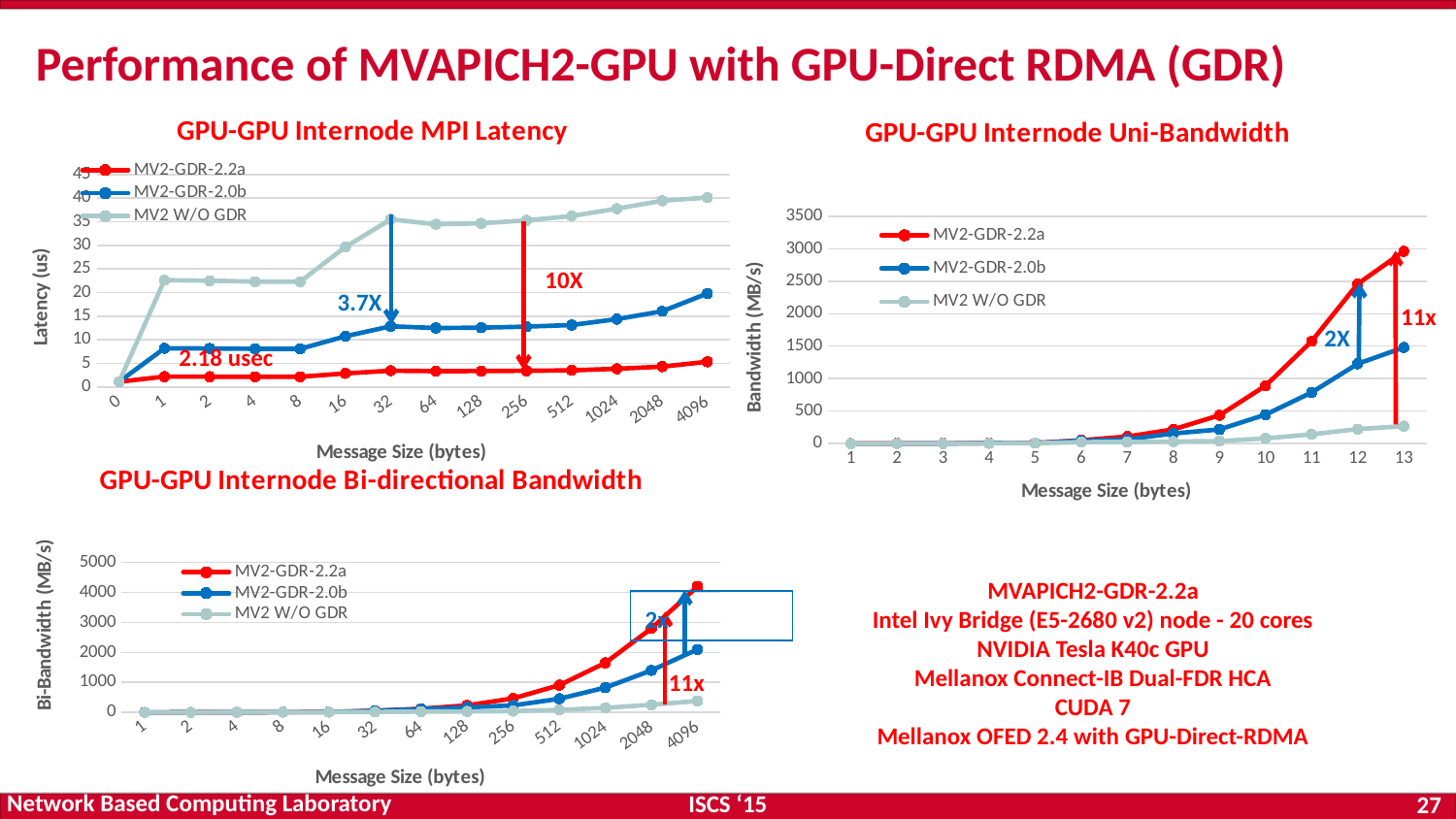
In the GPU-GPU Internode Uni-Bandwidth chart, which series has the lowest bandwidth at message size 13? MV2 W/O GDR In the GPU-GPU Internode Bi-directional Bandwidth chart, is the bi-bandwidth of MV2-GDR-2.2a at message size 4096 greater or less than 4000? greater How many series does the legend of the GPU-GPU Internode MPI Latency chart list? 3 In the GPU-GPU Internode MPI Latency chart, is the latency of MV2 W/O GDR at message size 4096 greater or less than 35? greater In the GPU-GPU Internode MPI Latency chart, which series has the highest latency at message size 4096? MV2 W/O GDR In the GPU-GPU Internode MPI Latency chart, which series has the lowest latency at message size 4096? MV2-GDR-2.2a In the GPU-GPU Internode Bi-directional Bandwidth chart, does the bi-bandwidth of MV2-GDR-2.2a rise or fall as message size increases? rise In the GPU-GPU Internode MPI Latency chart, is the latency of MV2-GDR-2.2a at message size 4096 greater or less than 10? less In the GPU-GPU Internode MPI Latency chart, what latency value is annotated for MV2-GDR-2.2a at small message sizes? 2.18 usec What kind of chart is the GPU-GPU Internode MPI Latency chart? line chart How many message-size points are plotted along the x axis of the GPU-GPU Internode Uni-Bandwidth chart? 13